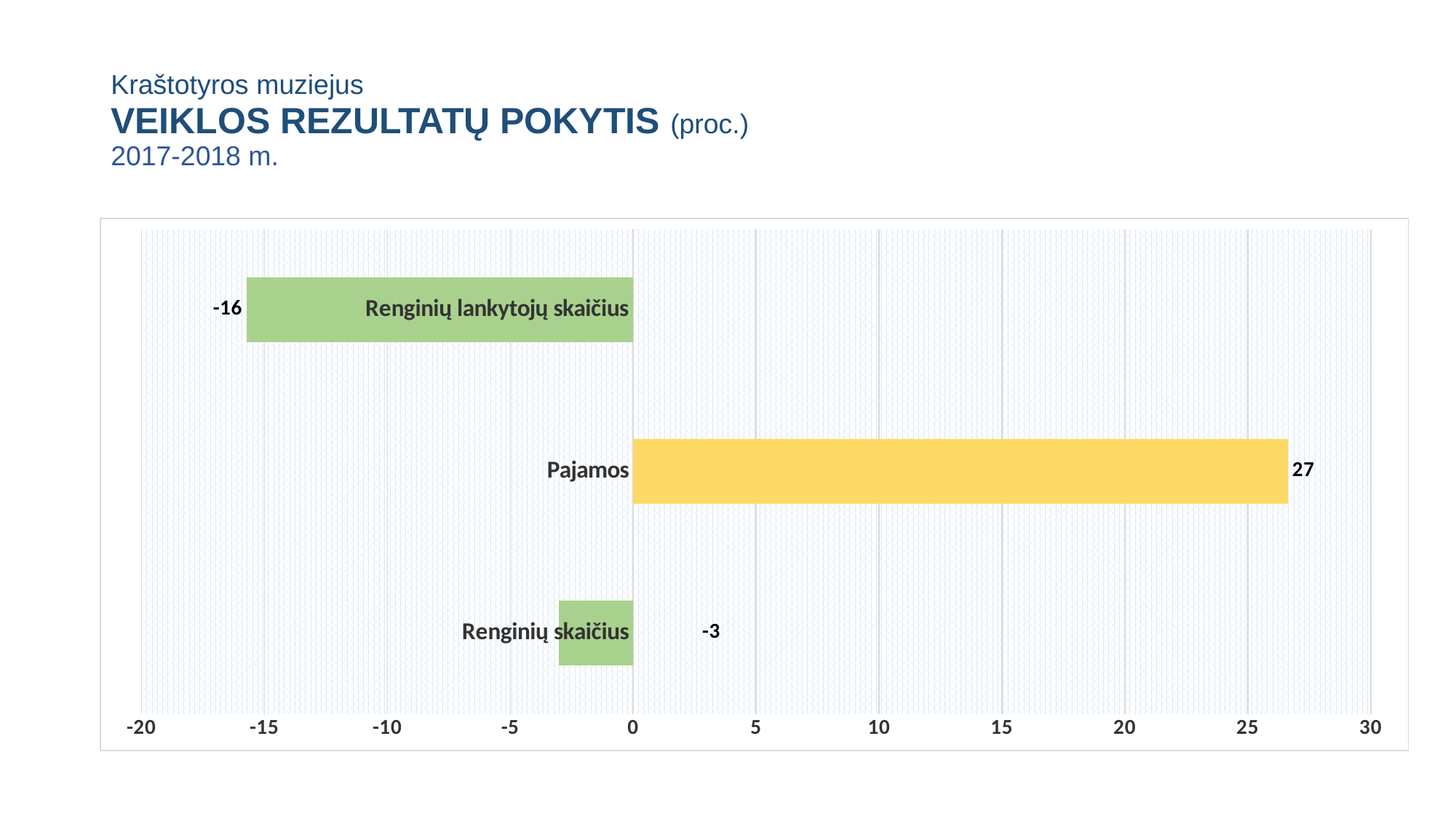
Is the value for Pajamos greater or less than 25? greater Which is larger, the value for Renginių skaičius or the value for Renginių lankytojų skaičius? Renginių skaičius What kind of chart is shown on the slide? Bar chart Which category has the lowest value? Renginių lankytojų skaičius What is the difference between the values for Renginių skaičius and Renginių lankytojų skaičius? 13 What is the value for Renginių skaičius? -3 What is the difference between the values for Pajamos and Renginių skaičius? 30 What colour is the bar for Pajamos? Yellow How many categories are shown in the chart? 3 What is the value for Pajamos? 27 Which category has the highest value? Pajamos What is the value for Renginių lankytojų skaičius? -16